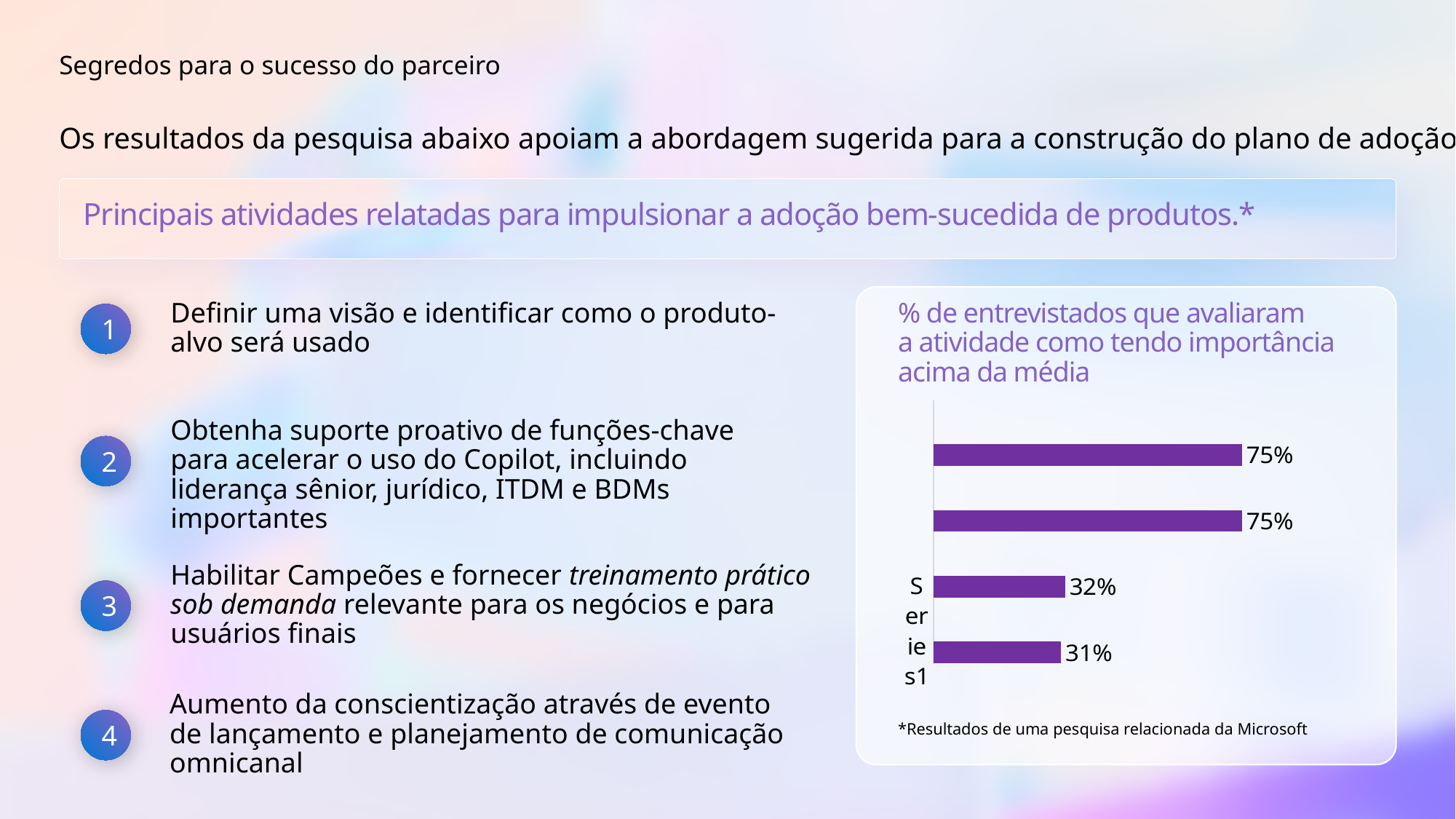
What kind of chart is shown on the slide? bar chart What is the value shown on the third bar from the top of the chart? 32% What is the title of the chart? % de entrevistados que avaliaram a atividade como tendo importância acima da média What is the difference between the third bar from the top and the bottom bar? 1% What is the highest value shown in the chart? 75% What is the value shown on the second bar from the top of the chart? 75% What is the lowest value shown in the chart? 31% Which is larger, the value of the top bar or the value of the third bar from the top? the top bar How many bars does the chart show? 4 What is the value shown on the top bar of the chart? 75% What is the difference between the value of the top bar and the value of the bottom bar? 44% What is the value shown on the bottom bar of the chart? 31%